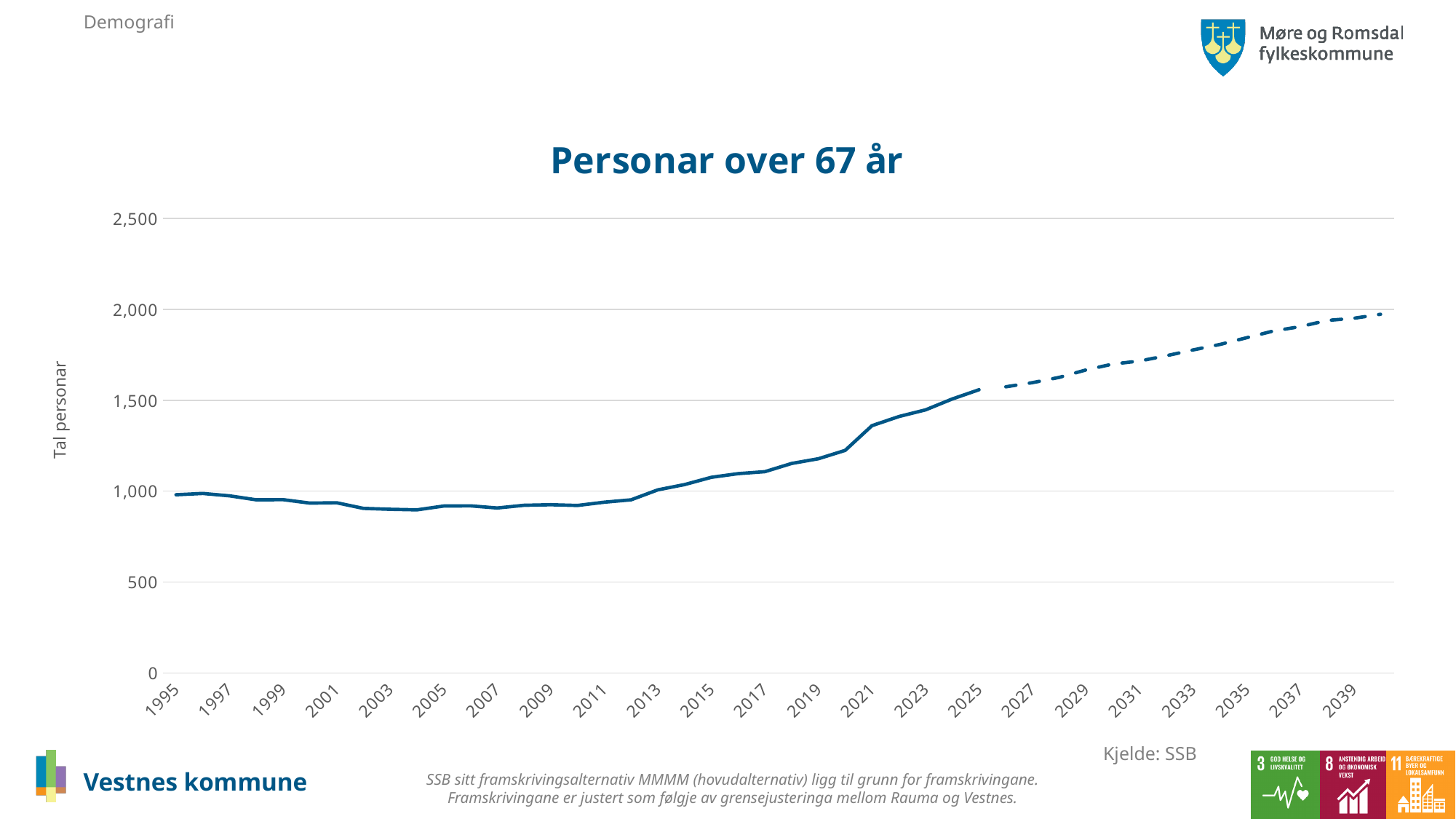
Is the value for 2011 greater or less than 1,000? less Do the values rise or fall from 1995 to 2003? fall Is the value for 2021 greater or less than 1,000? greater Which year has the larger value, 1995 or 2025? 2025 What is the title of the chart? Personar over 67 år Which year has the larger value, 2021 or 2039? 2039 Is the value for 2025 greater or less than 1,500? greater What kind of chart is shown on the slide? line chart Overall, do the values rise or fall from 2013 to 2039? rise What is the label on the vertical axis of the chart? Tal personar